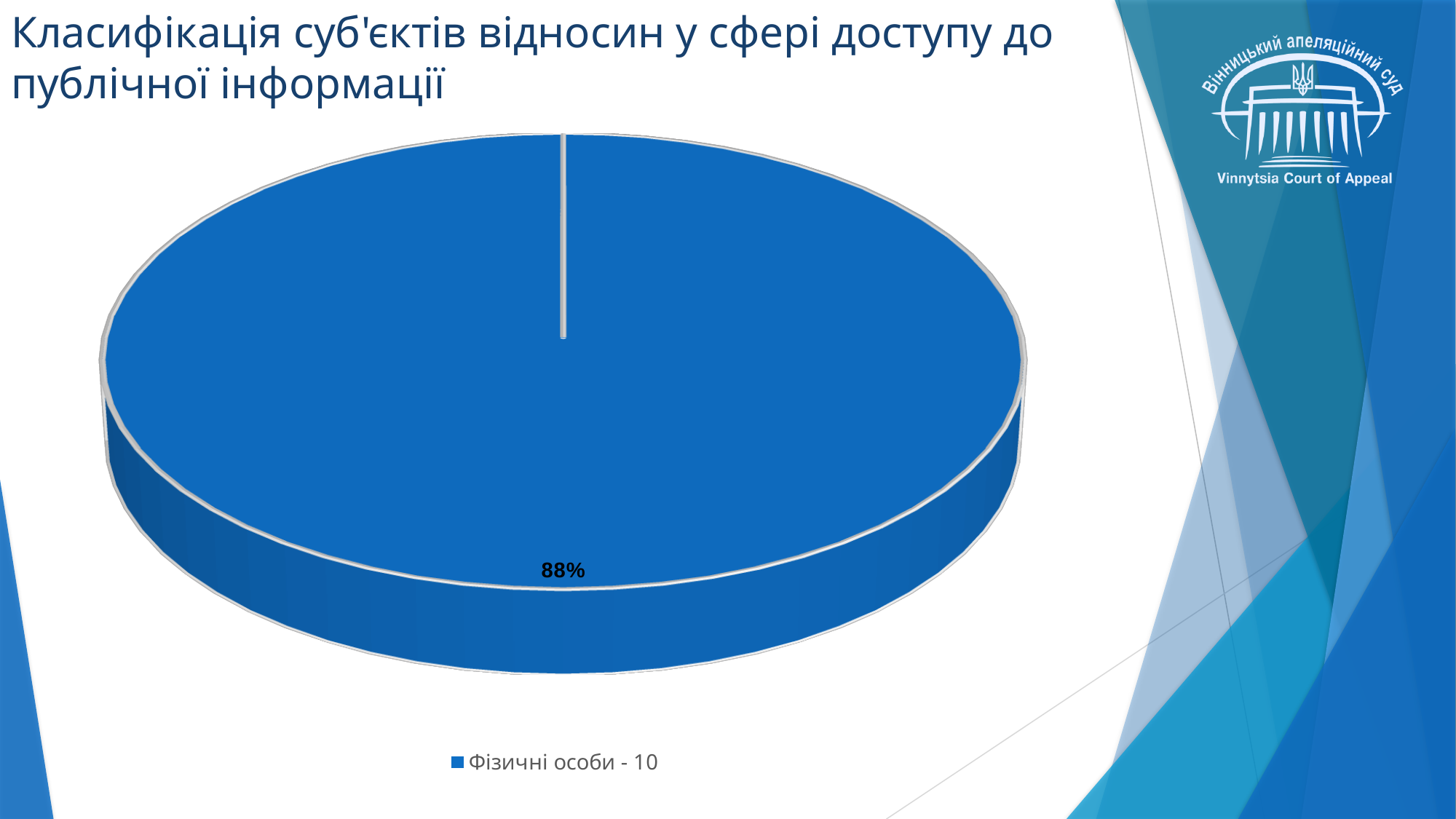
What is the legend entry shown below the pie chart? Фізичні особи - 10 What number is given after the category name Фізичні особи in the legend? 10 What is the share of the pie labelled for Фізичні особи? 88% Is the share for Фізичні особи greater or less than 50%? greater How many entries does the chart legend list? 1 What percentage is printed on the pie slice for Фізичні особи? 88% What is the title of the slide containing the pie chart? Класифікація суб'єктів відносин у сфері доступу до публічної інформації What kind of chart is shown on the slide? pie chart